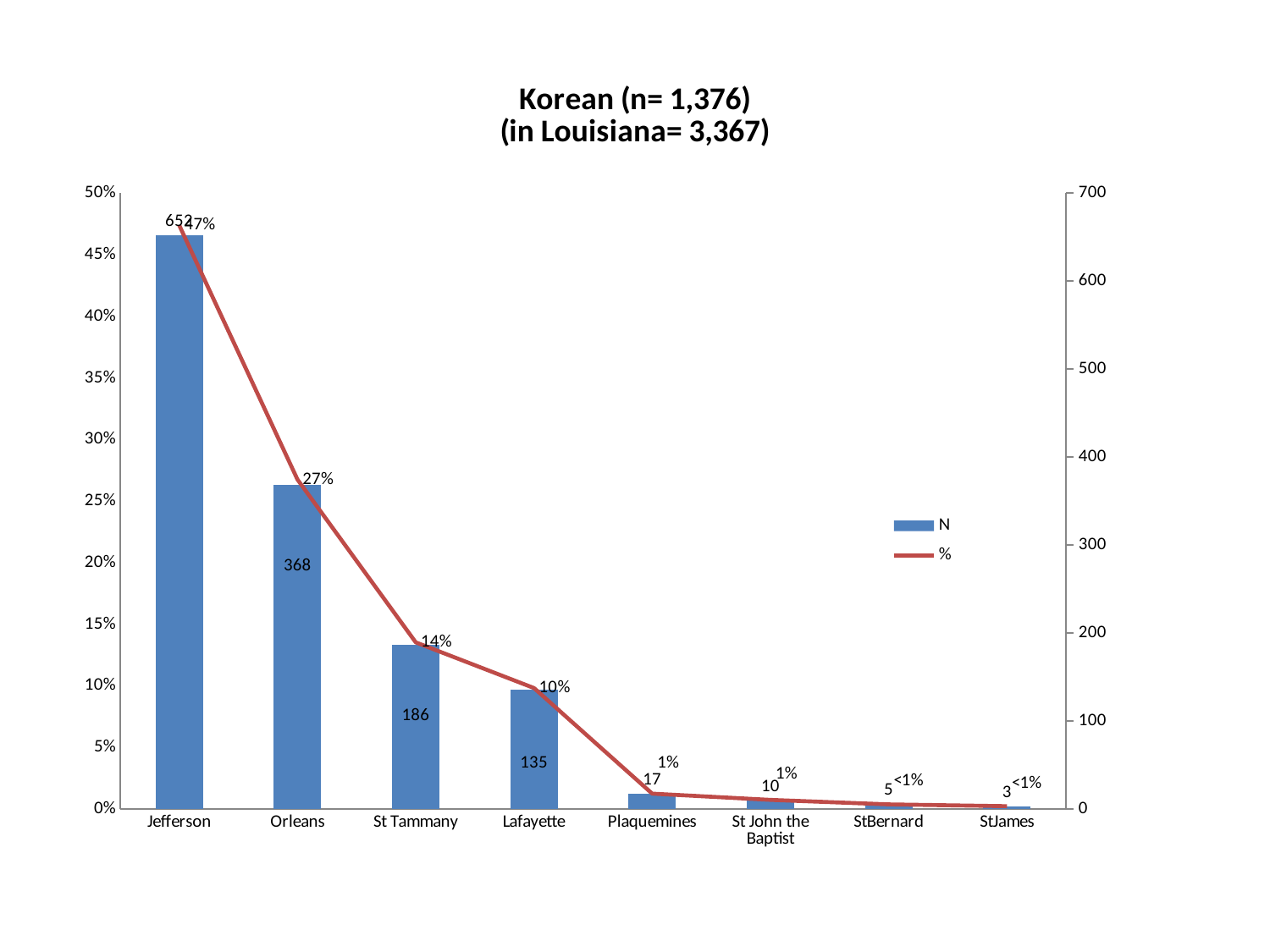
How many parishes are shown on the x axis? 8 Do the N values rise or fall from Jefferson to St James along the x axis? fall What is the N value for Plaquemines? 17 What is the N value for Orleans? 368 Which has a larger N value, Lafayette or Plaquemines? Lafayette Which parish has the highest N value? Jefferson How many series does the legend list? 2 What is the difference between the N values for Orleans and St Tammany? 182 What is the title of the chart? Korean (n= 1,376) (in Louisiana= 3,367) What percentage is shown for Lafayette? 10% What is the N value for St Tammany? 186 Which parish has the lowest N value? StJames